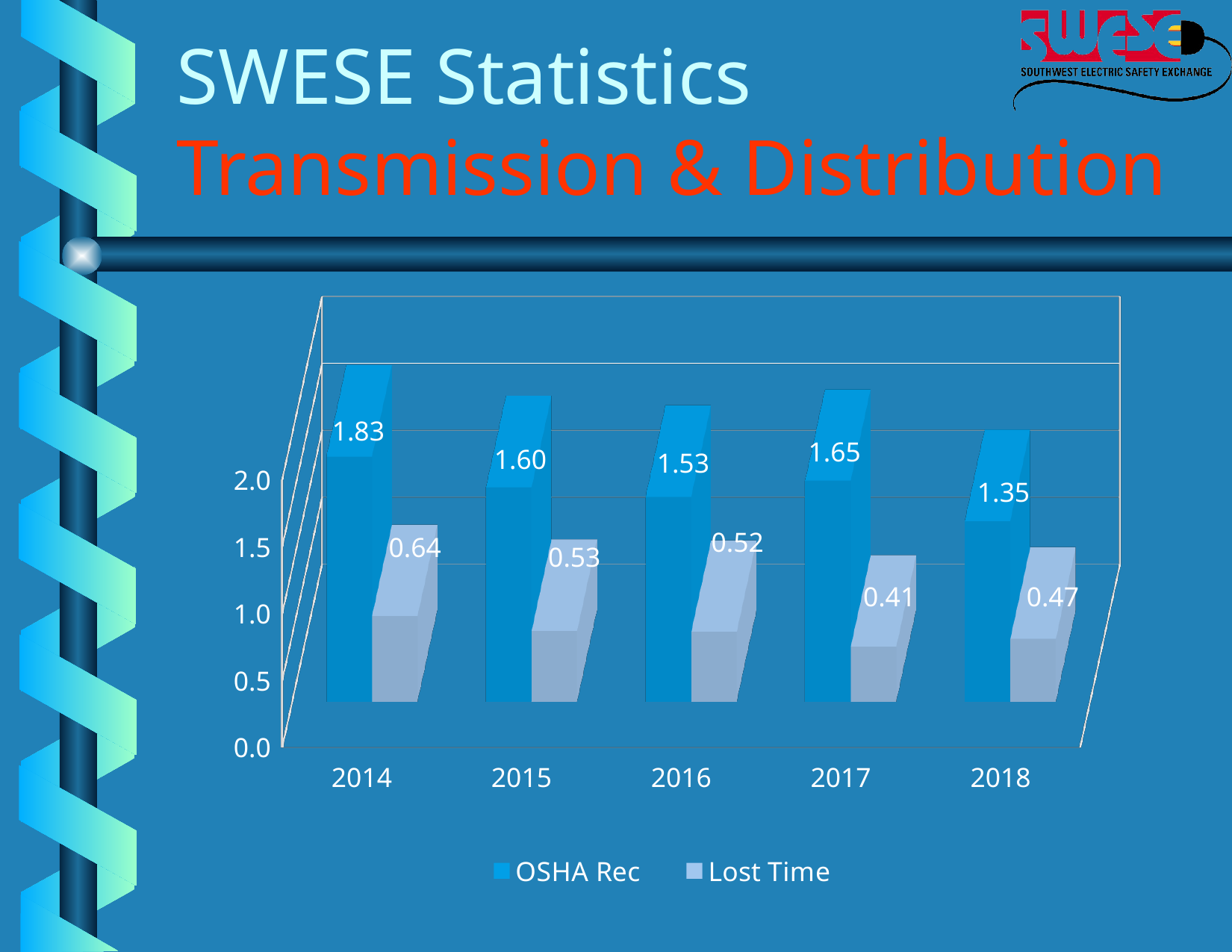
What is the OSHA Rec value for 2014? 1.83 What is the difference between the OSHA Rec value and the Lost Time value in 2016? 1.01 How many years are shown on the x axis? 5 Which year has the highest OSHA Rec value? 2014 Does the Lost Time value rise or fall from 2014 to 2017? Fall What are the two series named in the legend? OSHA Rec and Lost Time Which is larger, the OSHA Rec value for 2015 or the OSHA Rec value for 2017? 2017 What is the Lost Time value for 2017? 0.41 What is the OSHA Rec value for 2018? 1.35 What kind of chart is shown on the slide? Bar chart How many series does the legend list? 2 Which year has the lowest Lost Time value? 2017